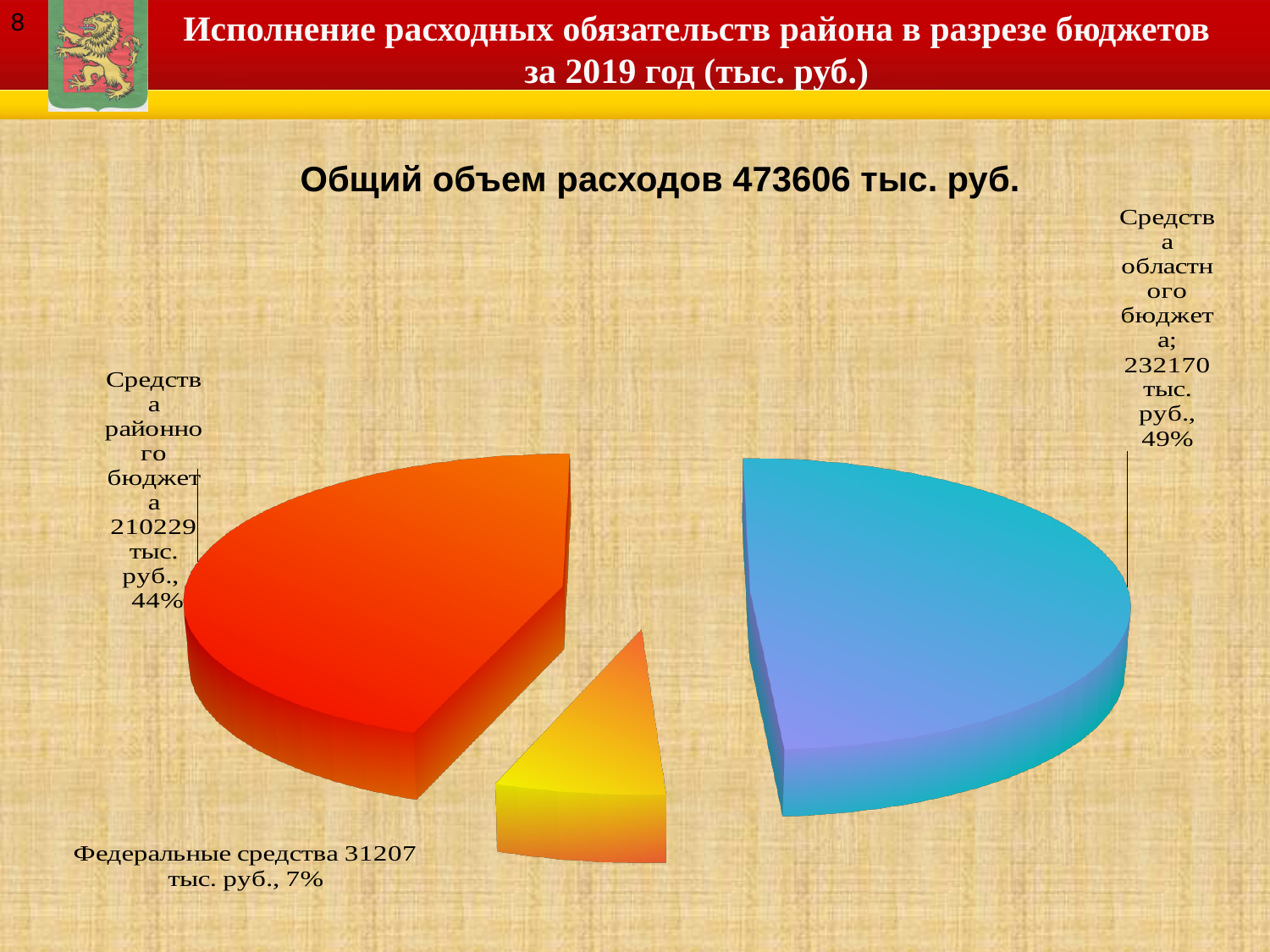
What is the value for Федеральные средства? 31207 тыс. руб. What is the value for Средства районного бюджета? 210229 тыс. руб. What share of the pie does Средства областного бюджета represent? 49% Which slice is the largest? Средства областного бюджета What share of the pie does Федеральные средства represent? 7% How many slices does the pie chart have? 3 Which is larger, Средства районного бюджета or Федеральные средства? Средства районного бюджета What is the value for Средства областного бюджета? 232170 тыс. руб. Which slice is the smallest? Федеральные средства What is the difference between Средства областного бюджета and Средства районного бюджета? 21941 тыс. руб. What total volume of expenditures is stated above the chart? 473606 тыс. руб. What kind of chart is shown on the slide? pie chart